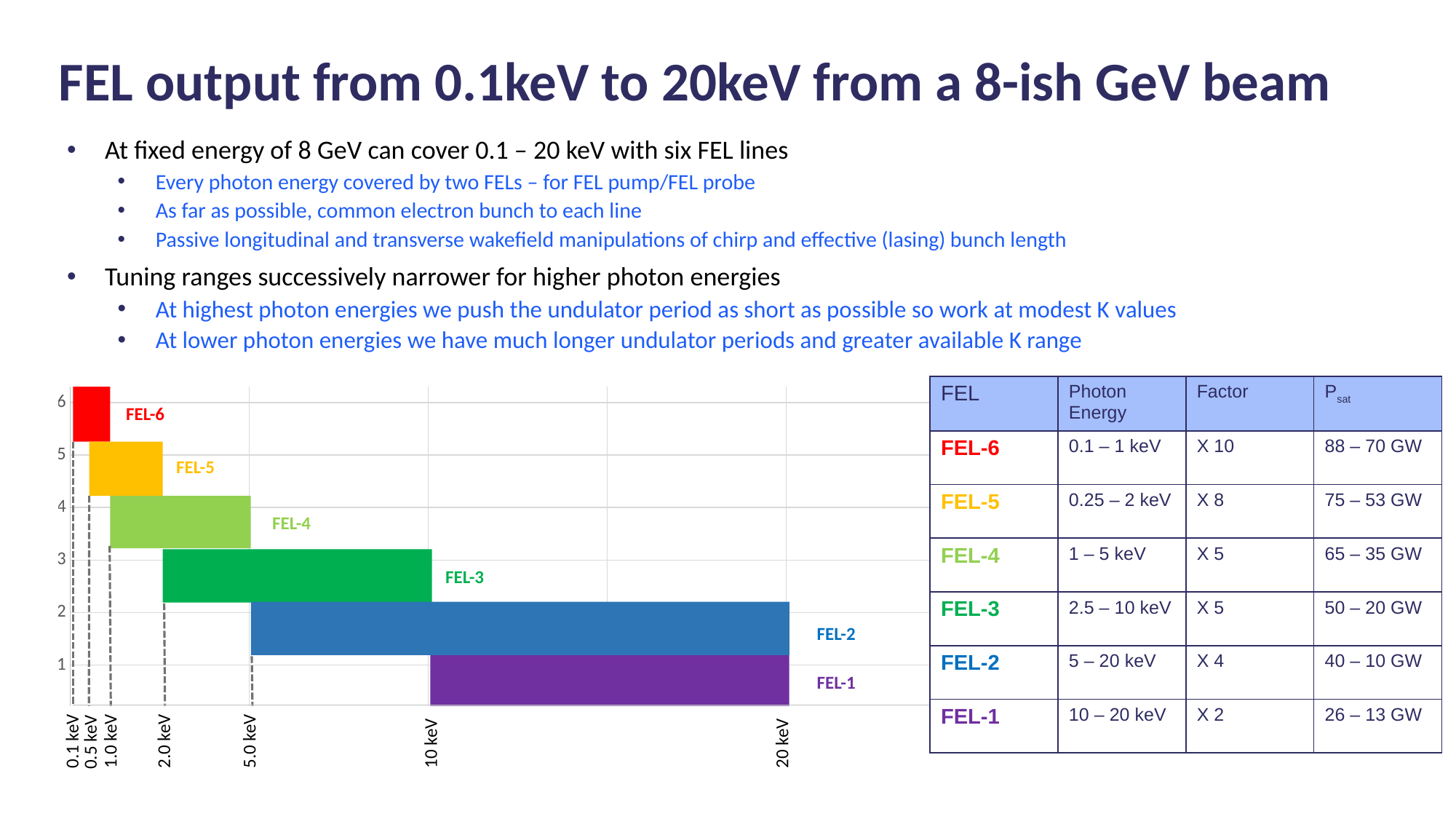
At what photon energy does the FEL-4 bar end? 5.0 keV Which FEL line reaches the lowest photon energy in the chart? FEL-6 What colour is the FEL-3 bar in the chart? Green Which FEL lines extend to 20 keV in the chart? FEL-1 and FEL-2 Is the lower end of the FEL-3 bar greater or less than 5.0 keV? less At what photon energy does the FEL-2 bar end? 20 keV Which bar covers a wider photon energy range, FEL-2 or FEL-1? FEL-2 At what photon energy does the FEL-6 bar start? 0.1 keV Which FEL line is plotted at the top of the chart? FEL-6 How many FEL lines are plotted in the chart? 6 What kind of chart is shown on the slide? Bar chart At what photon energy does the FEL-1 bar start? 10 keV